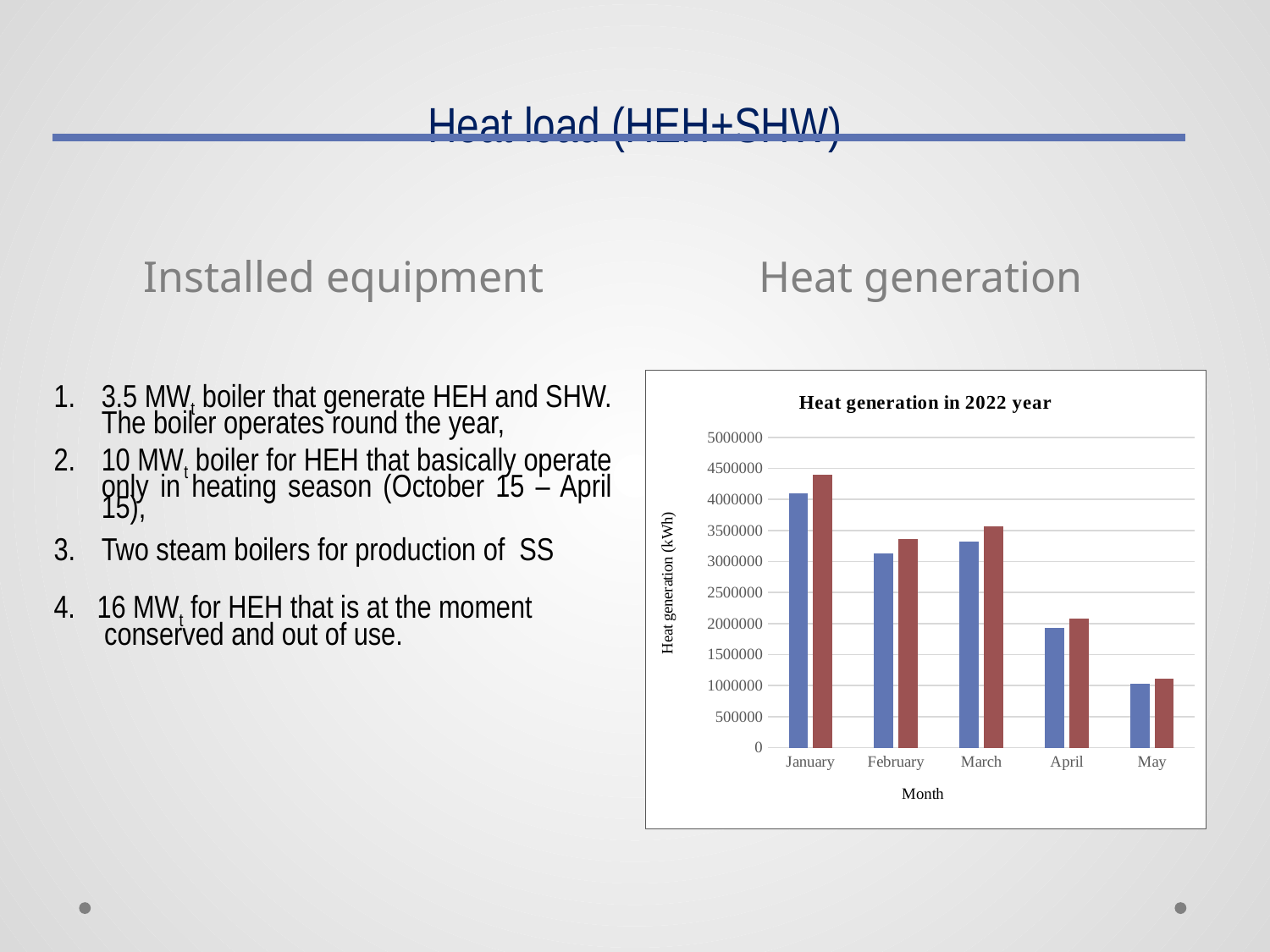
How many months are shown on the x axis of the chart? 5 What is the title of the chart? Heat generation in 2022 year Is the value of the red bar for January greater or less than 4000000? greater Which month has a higher blue bar, February or March? March Which month has the lowest heat generation in the chart? May Is the value of the red bar for May greater or less than 1500000? less Is the value of the blue bar for March greater or less than 3500000? less What is the label of the vertical axis of the chart? Heat generation (kWh) Which month has the highest heat generation in the chart? January In January, which bar is taller, the blue bar or the red bar? the red bar What kind of chart is shown on the slide? bar chart